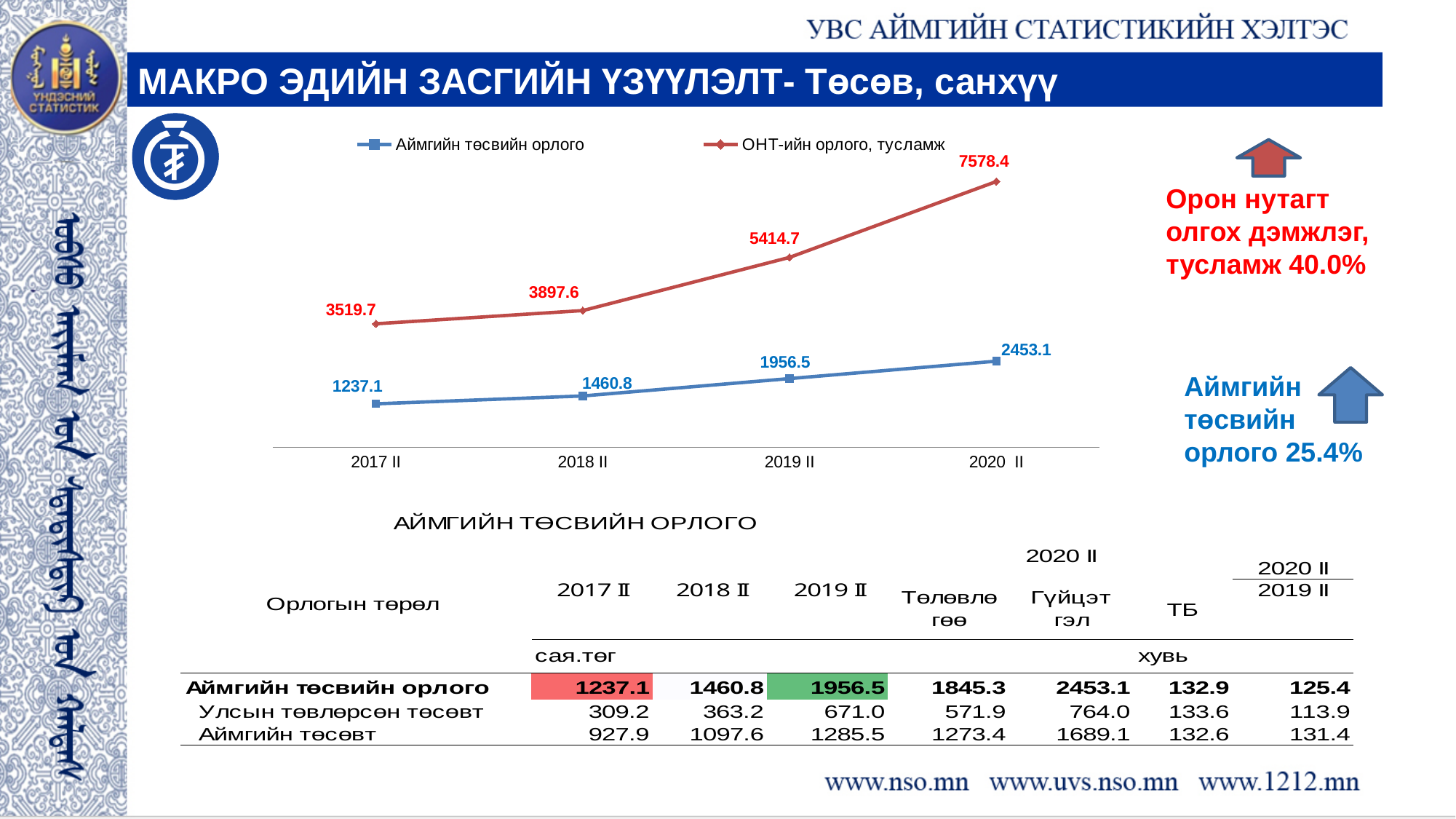
How many time points are plotted along the x axis of the chart? 4 What is the value of Аймгийн төсвийн орлого for 2017 II? 1237.1 In which period is ОНТ-ийн орлого, тусламж lowest? 2017 II What is the difference between ОНТ-ийн орлого, тусламж in 2020 II and 2019 II? 2163.7 How many series does the chart legend list? 2 In which period is Аймгийн төсвийн орлого highest? 2020 II What is the value of ОНТ-ийн орлого, тусламж for 2018 II? 3897.6 Which colour is used for the ОНТ-ийн орлого, тусламж line? red What type of chart is shown on the slide? line chart Which is larger in 2019 II: Аймгийн төсвийн орлого or ОНТ-ийн орлого, тусламж? ОНТ-ийн орлого, тусламж Does Аймгийн төсвийн орлого rise or fall from 2017 II to 2020 II? rise What is the value of ОНТ-ийн орлого, тусламж for 2020 II? 7578.4